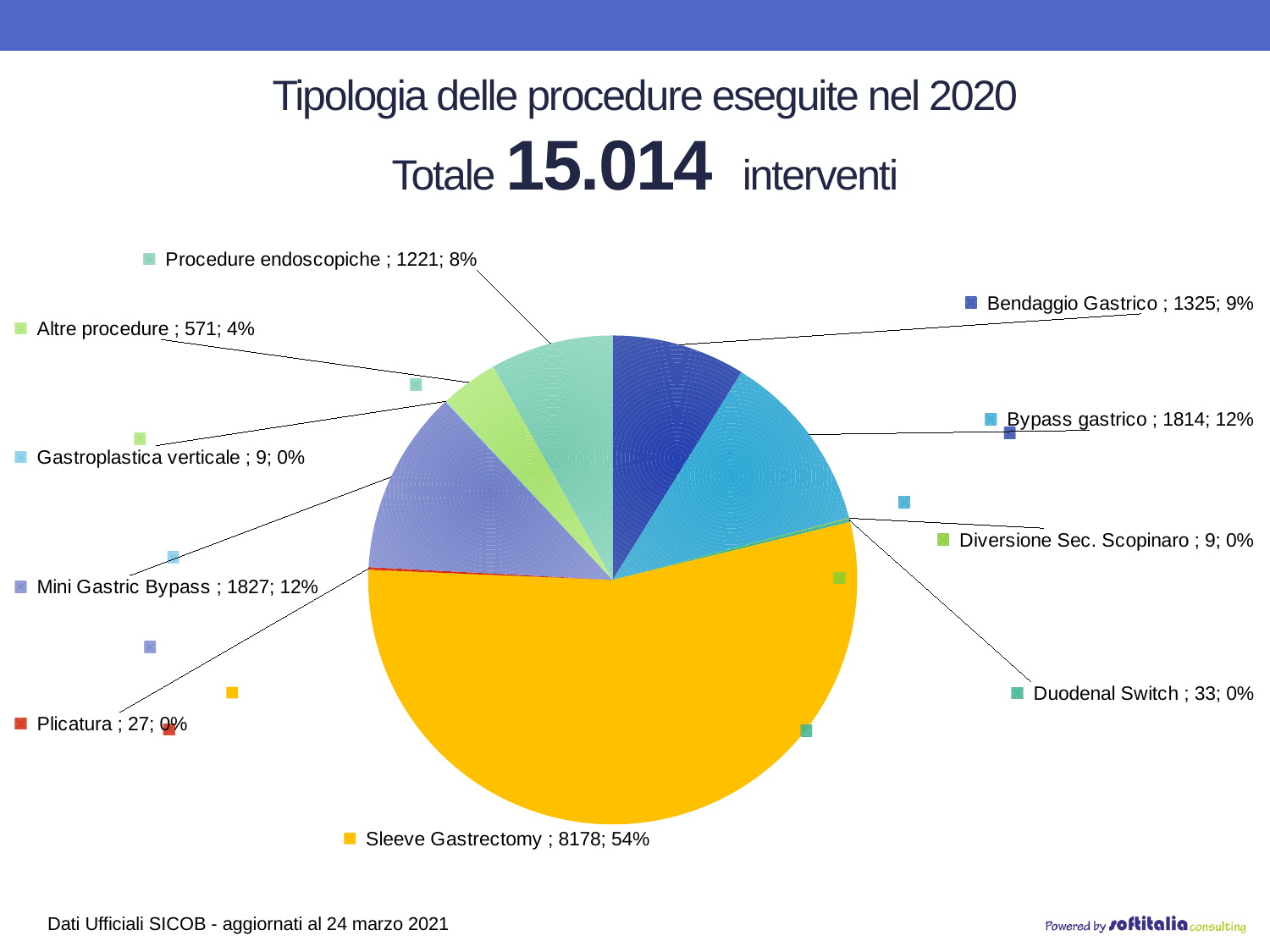
What is the value for Plicatura? 27 How many categories (slices) does the pie chart show? 10 What is the value for Sleeve Gastrectomy? 8178 What share of the pie does Sleeve Gastrectomy represent? 54% Which is larger, the value for Bendaggio Gastrico or the value for Procedure endoscopiche? Bendaggio Gastrico What percentage is shown for Procedure endoscopiche? 8% What is the difference between the values for Mini Gastric Bypass and Bypass gastrico? 13 What is the difference between the values for Sleeve Gastrectomy and Altre procedure? 7607 What is the value for Bypass gastrico? 1814 What kind of chart is shown on the slide? pie chart Which category has the largest slice of the pie? Sleeve Gastrectomy What total number of interventions is stated in the slide title? 15.014